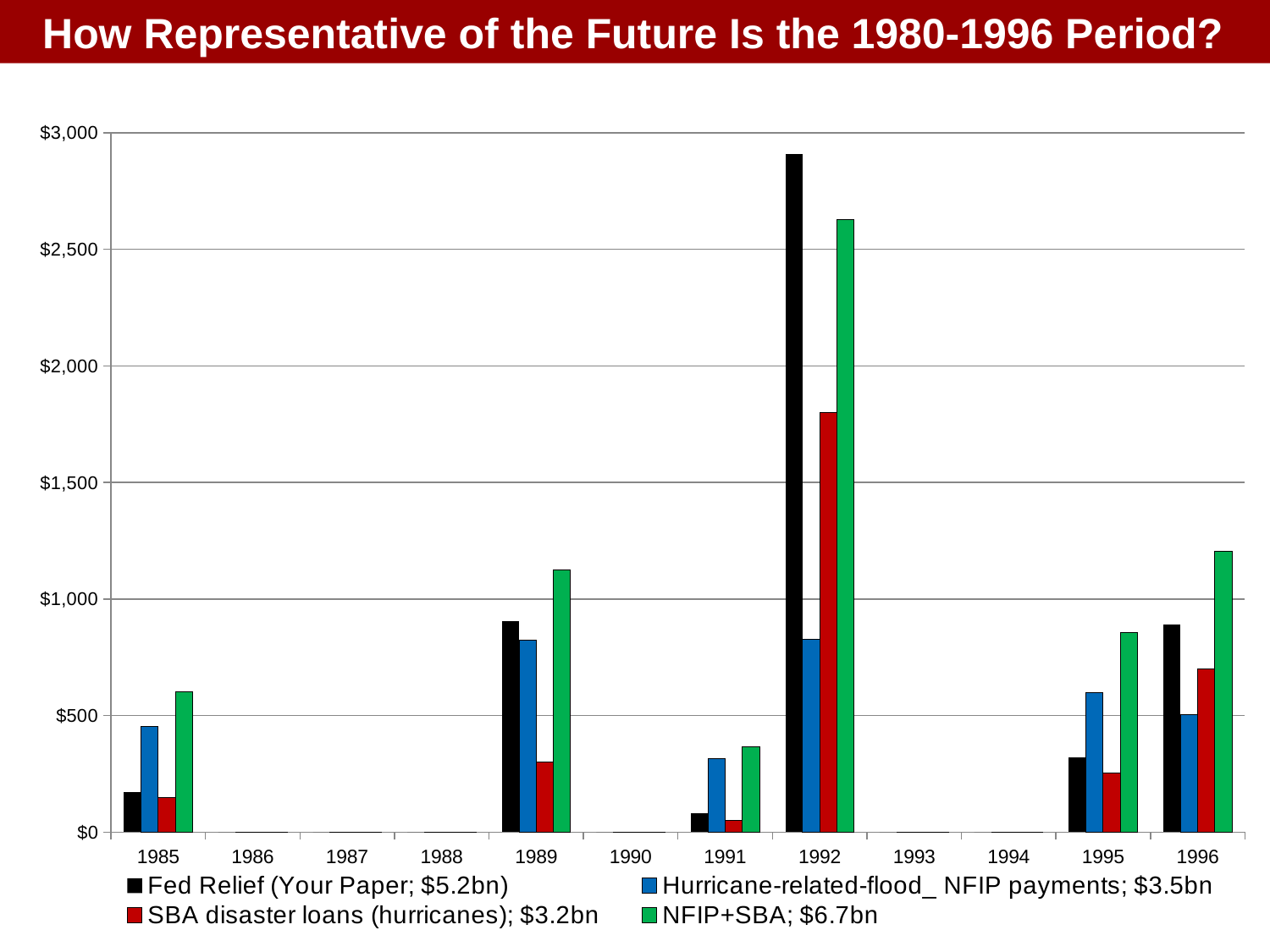
What total amount does the legend give for NFIP+SBA? $6.7bn In which year is the Fed Relief (Your Paper) bar highest? 1992 Is the Fed Relief (Your Paper) value for 1992 greater or less than $2,500? greater What is the title of the slide? How Representative of the Future Is the 1980-1996 Period? How many years are shown along the x axis? 12 Is the SBA disaster loans (hurricanes) value for 1992 greater or less than $1,500? greater In 1992, which is larger: Fed Relief (Your Paper) or NFIP+SBA? Fed Relief (Your Paper) Is the NFIP+SBA value for 1996 greater or less than $1,000? greater What kind of chart is shown on the slide? bar chart In 1995, which is larger: Hurricane-related-flood_ NFIP payments or SBA disaster loans (hurricanes)? Hurricane-related-flood_ NFIP payments How many series does the legend list? 4 In which year is the NFIP+SBA bar highest? 1992